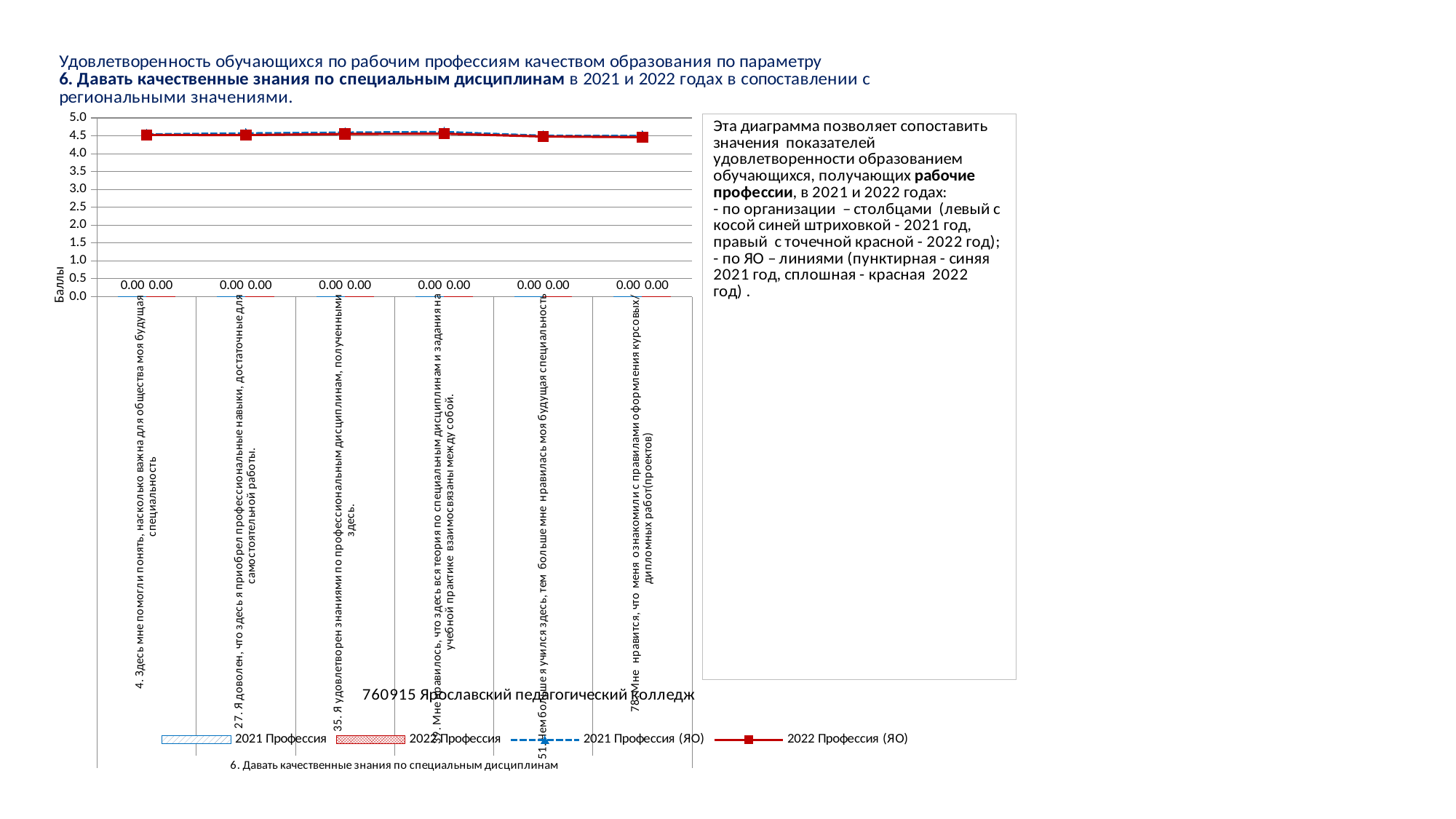
What kind of chart is shown on the slide? bar and line chart For category "51. Чем больше я учился здесь, тем больше мне нравилась моя будущая специальность", which is larger: the 2021 Профессия value or the 2021 Профессия (ЯО) value? 2021 Профессия (ЯО) Is the value of the 2021 Профессия (ЯО) line for category "35. Я удовлетворен знаниями по профессиональным дисциплинам, полученными здесь." greater or less than 3.0? greater What is the difference between the 2021 Профессия and 2022 Профессия values for category "27. Я доволен, что здесь я приобрел профессиональные навыки, достаточные для самостоятельной работы."? 0.00 What is the value of the 2022 Профессия series for category "78. Мне нравится, что меня ознакомили с правилами оформления курсовых/дипломных работ(проектов)"? 0.00 How many categories (questions) are plotted along the x axis of the chart? 6 Which legend entry is drawn as a solid red line with square markers? 2022 Профессия (ЯО) What is the label of the vertical axis of the chart? Баллы What is the value of the 2021 Профессия series for category "4. Здесь мне помогли понять, насколько важна для общества моя будущая специальность"? 0.00 Is the value of the 2022 Профессия (ЯО) line for category "4. Здесь мне помогли понять, насколько важна для общества моя будущая специальность" greater or less than 4.0? greater How many series does the chart legend list? 4